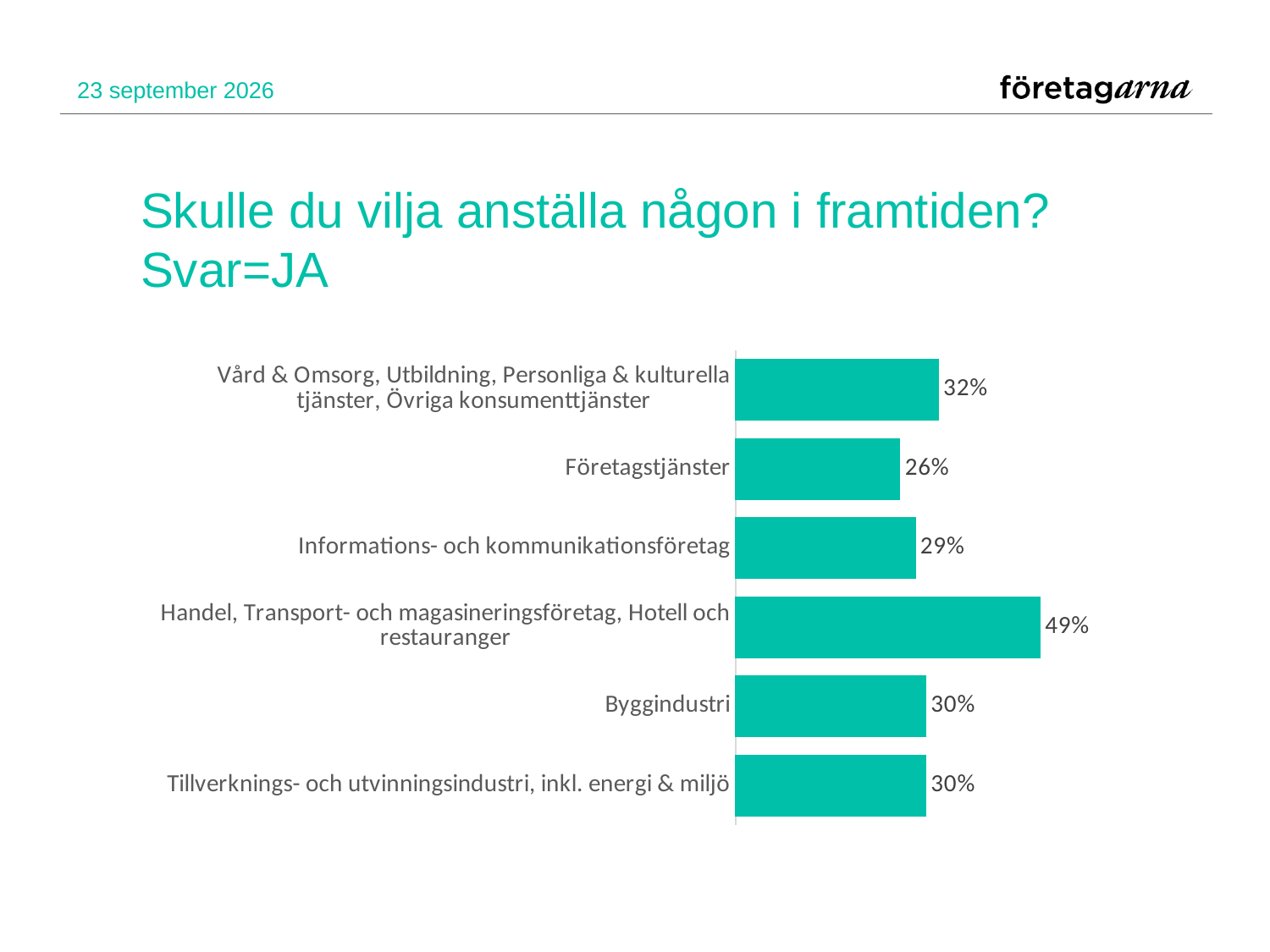
What is the value for Handel, Transport- och magasineringsföretag, Hotell och restauranger? 49% What is the title of the slide? Skulle du vilja anställa någon i framtiden? Svar=JA What is the value for Företagstjänster? 26% How many categories are shown in the chart? 6 What is the difference between the values for Handel, Transport- och magasineringsföretag, Hotell och restauranger and Företagstjänster? 23% Which category has the lowest value? Företagstjänster What is the value for Byggindustri? 30% Which category has the highest value? Handel, Transport- och magasineringsföretag, Hotell och restauranger What is the difference between the values for Vård & Omsorg, Utbildning, Personliga & kulturella tjänster, Övriga konsumenttjänster and Informations- och kommunikationsföretag? 3% What is the value for Informations- och kommunikationsföretag? 29% What kind of chart is shown on the slide? Bar chart Which is larger, the value for Vård & Omsorg, Utbildning, Personliga & kulturella tjänster, Övriga konsumenttjänster or the value for Byggindustri? Vård & Omsorg, Utbildning, Personliga & kulturella tjänster, Övriga konsumenttjänster